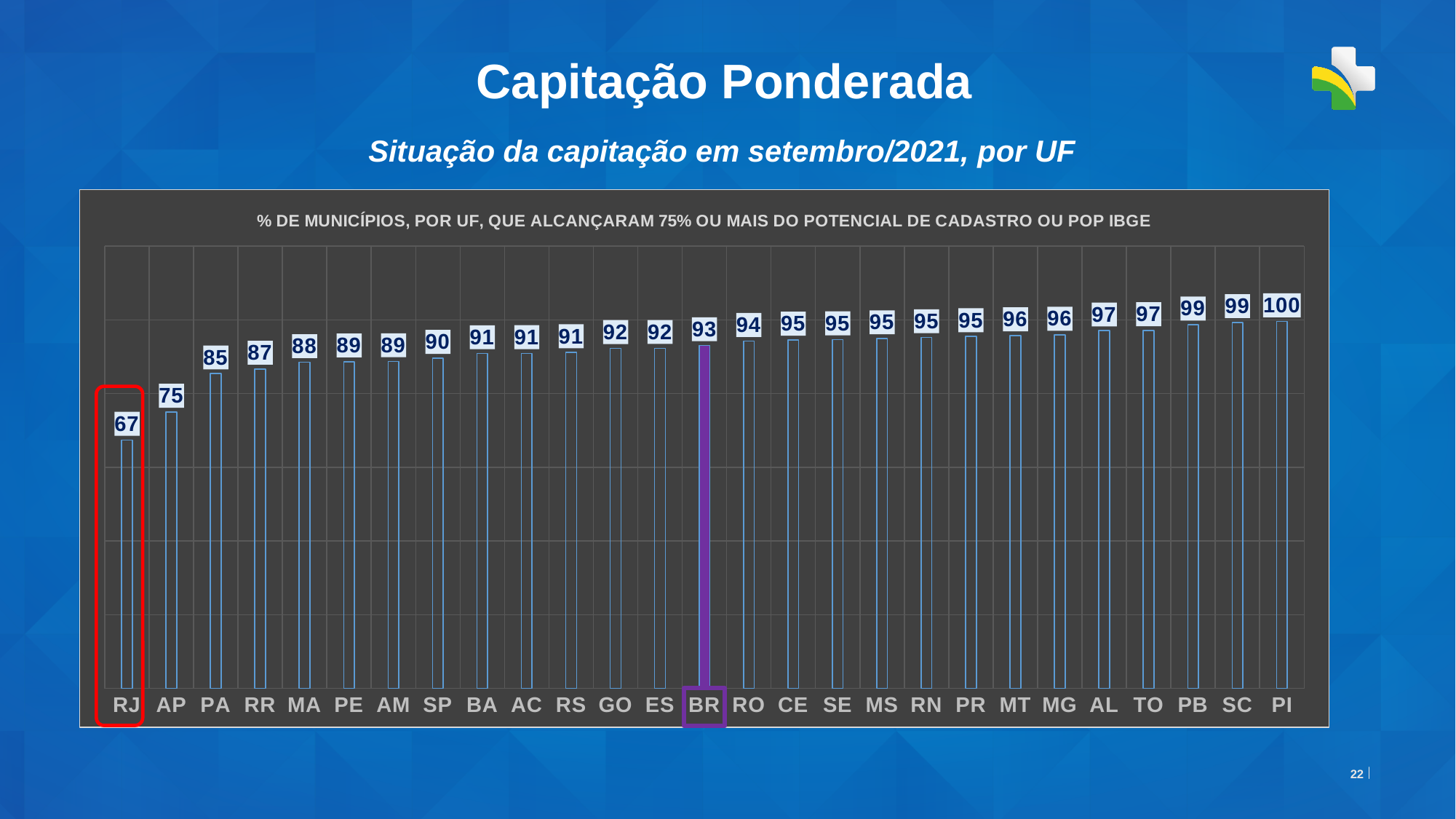
What is the value for MG? 96 What is the difference between the values for PI and RJ? 33 Which is larger, the value for PA or the value for AP? PA What kind of chart is this? Bar chart Which category has the lowest value? RJ How many categories are shown on the x axis? 27 What is the value for RJ? 67 Do the values rise or fall from left to right along the x axis? Rise What is the difference between the values for AP and RJ? 8 What is the value for SP? 90 Which category has the highest value? PI What is the value for BR? 93